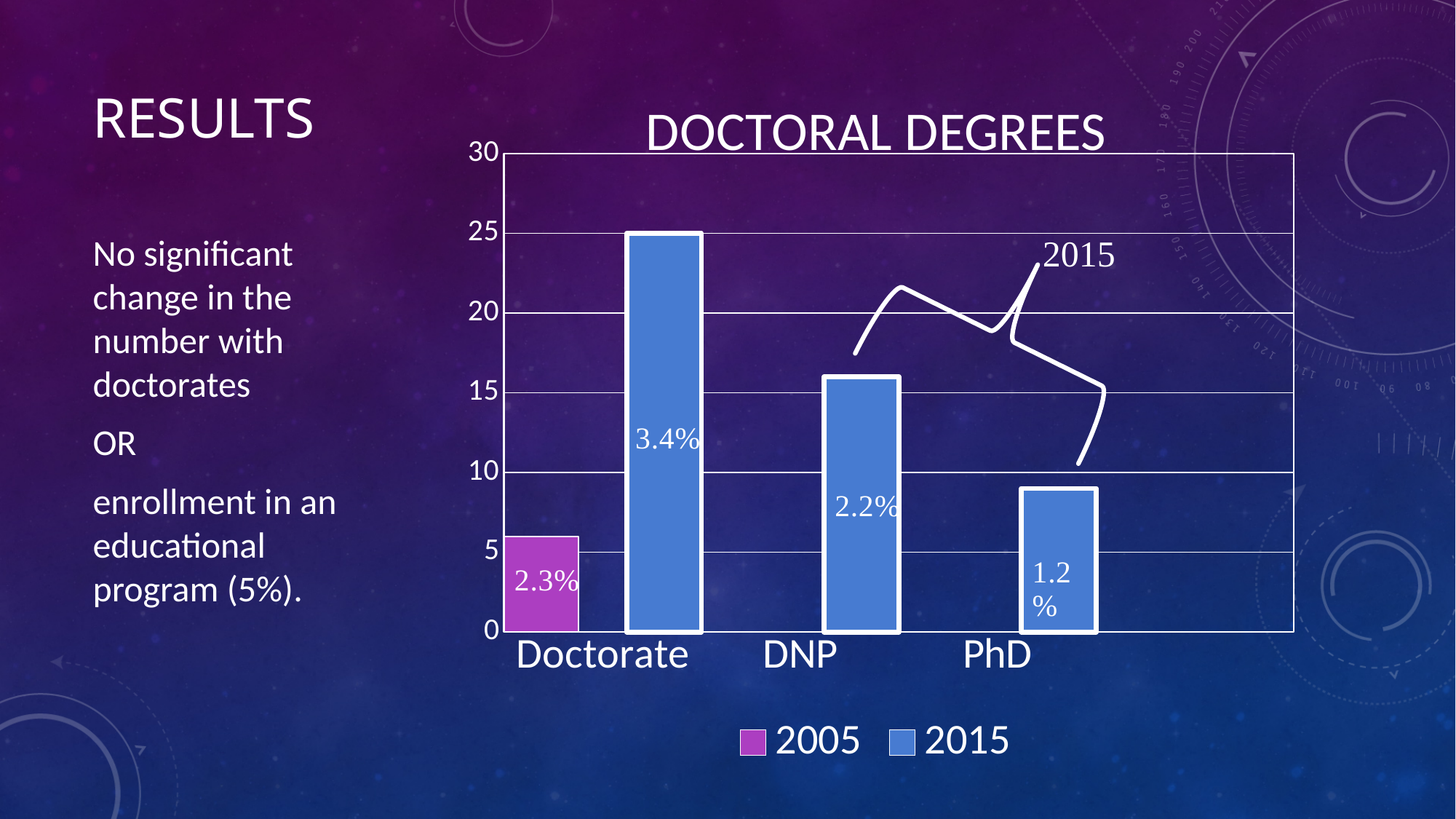
What data label is printed on the 2015 bar for DNP? 2.2% Is the 2015 bar for DNP greater or less than 15 on the axis? greater What data label is printed on the 2015 bar for Doctorate? 3.4% What data label is printed on the 2005 bar for Doctorate? 2.3% Which is taller, the 2015 bar for PhD or the 2015 bar for DNP? DNP Which category has the tallest 2015 bar? Doctorate What is the title of the chart? DOCTORAL DEGREES What kind of chart is shown on the slide? bar chart Which category has the shortest 2015 bar? PhD What data label is printed on the 2015 bar for PhD? 1.2% How many series does the legend list? 2 How many categories are shown on the x axis? 3